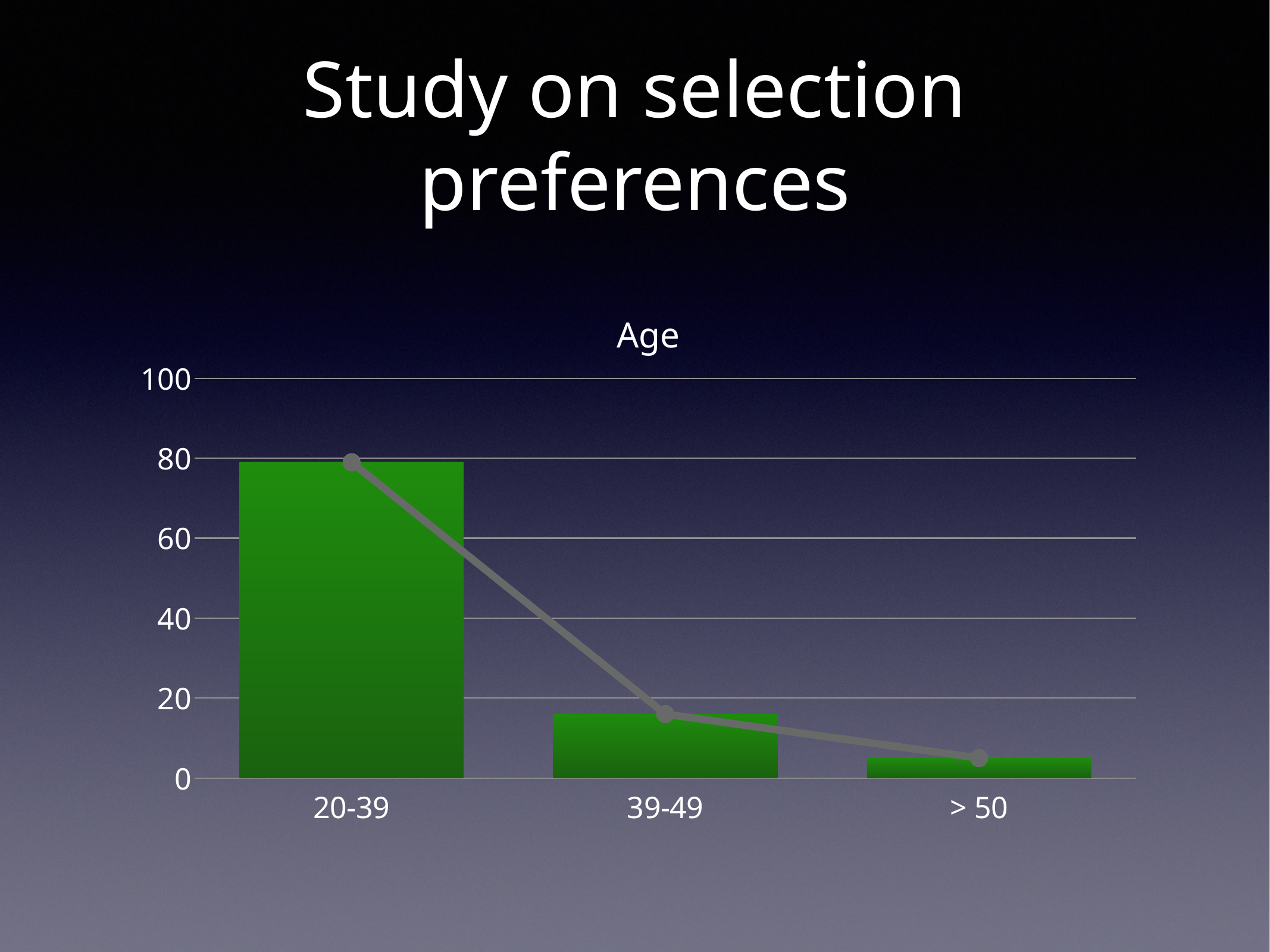
How many age categories are shown on the x axis? 3 Which is larger, the value for 39-49 or the value for > 50? 39-49 Do the values rise or fall from 20-39 to > 50 along the x axis? fall Which age category has the highest value? 20-39 What is the highest value shown on the vertical axis? 100 What kind of chart is shown on the slide? combination bar and line chart What is the title of the chart? Age Which age category has the lowest value? > 50 Is the value for > 50 greater or less than 20? less Is the value for 20-39 greater or less than 60? greater Is the value for 39-49 greater or less than 20? less Which is larger, the value for 20-39 or the value for 39-49? 20-39